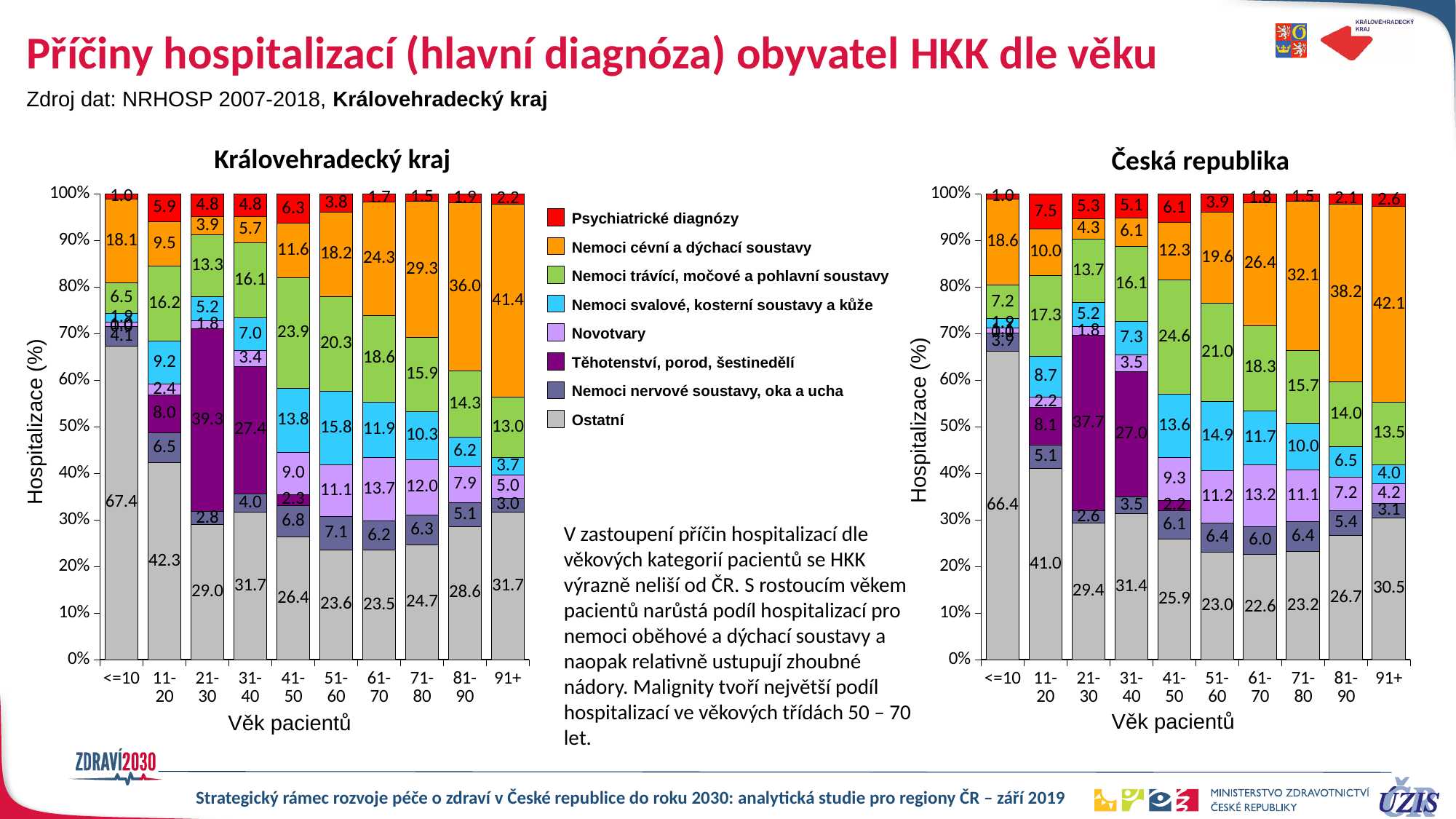
In the Česká republika chart, what is the value of Nemoci cévní a dýchací soustavy for the 91+ age group? 42.1 In the Královehradecký kraj chart, which age group has the highest value for Nemoci cévní a dýchací soustavy? 91+ In the Královehradecký kraj chart, what is the difference between the Psychiatrické diagnózy values for the 11-20 and 91+ age groups? 3.7 In the Česká republika chart, which age group has the lowest value for Ostatní? 61-70 What kind of chart is the Česká republika chart? Stacked bar chart In the Královehradecký kraj chart, does the value of Nemoci cévní a dýchací soustavy rise or fall from the 41-50 age group to the 91+ age group? Rise In the Česká republika chart, which is larger: Nemoci trávicí, močové a pohlavní soustavy for 41-50 or for 51-60? 41-50 In the Česká republika chart, what is the value of Novotvary for the 61-70 age group? 13.2 In the Královehradecký kraj chart, what is the value of Ostatní for the <=10 age group? 67.4 How many age groups are shown on the x axis of the Královehradecký kraj chart? 10 How many series does the legend list? 8 In the Královehradecký kraj chart, what is the value of Těhotenství, porod, šestinedělí for the 21-30 age group? 39.3